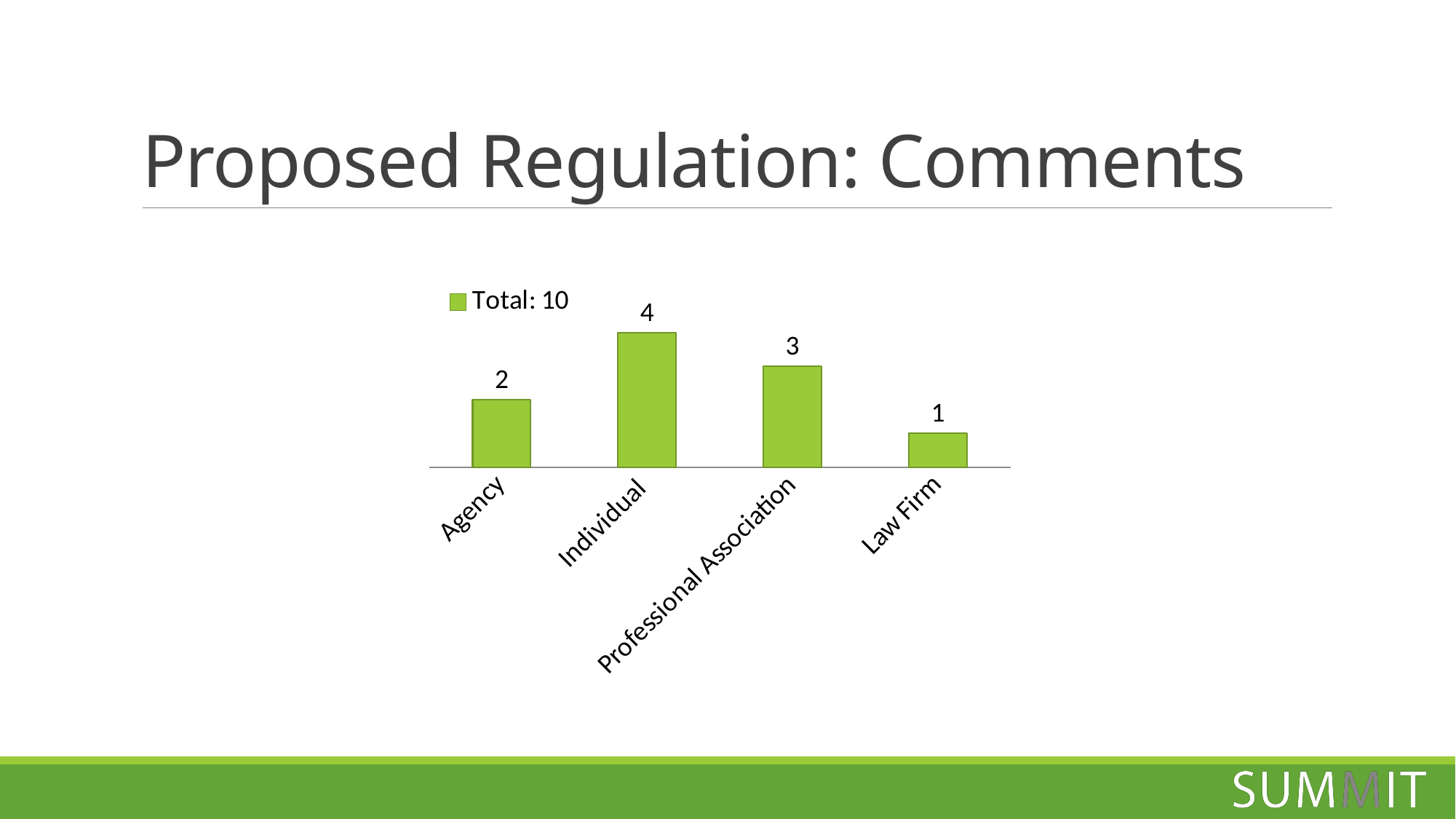
Which category has the highest value? Individual What is the value for Individual? 4 What is the legend entry for the series? Total: 10 What is the value for Law Firm? 1 Which category has the lowest value? Law Firm What kind of chart is shown on the slide? bar chart What is the value for Professional Association? 3 How many series does the legend list? 1 What is the value for Agency? 2 How many categories are shown on the x axis? 4 What is the difference between the values for Individual and Agency? 2 Which is larger, the value for Professional Association or the value for Law Firm? Professional Association